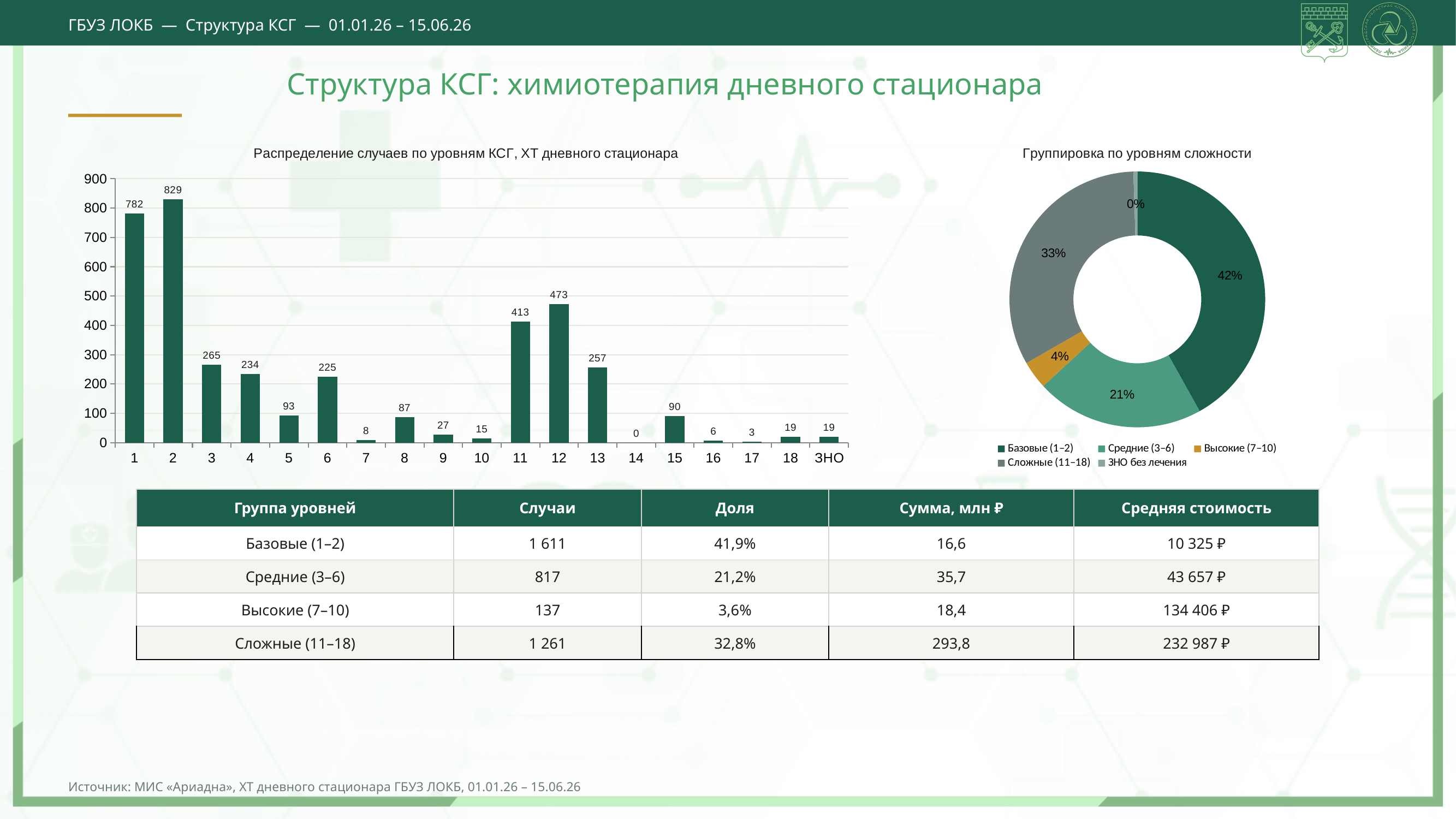
In the bar chart "Распределение случаев по уровням КСГ, ХТ дневного стационара", which is larger: the value for category 11 or category 13? 11 In the bar chart "Распределение случаев по уровням КСГ, ХТ дневного стационара", which category has the highest value? 2 In the bar chart "Распределение случаев по уровням КСГ, ХТ дневного стационара", what is the value for category 12? 473 In the donut chart "Группировка по уровням сложности", what share does the "Высокие (7–10)" slice have? 4% What kind of chart is "Распределение случаев по уровням КСГ, ХТ дневного стационара"? Bar chart In the bar chart "Распределение случаев по уровням КСГ, ХТ дневного стационара", what is the value for category 2? 829 In the bar chart "Распределение случаев по уровням КСГ, ХТ дневного стационара", which category has the lowest value? 14 In the donut chart "Группировка по уровням сложности", which group has the largest share? Базовые (1–2) In the bar chart "Распределение случаев по уровням КСГ, ХТ дневного стационара", what is the difference between the values for categories 2 and 1? 47 In the bar chart "Распределение случаев по уровням КСГ, ХТ дневного стационара", how many categories are shown on the x axis? 19 How many entries does the legend of the chart "Группировка по уровням сложности" list? 5 In the donut chart "Группировка по уровням сложности", what share does the "Сложные (11–18)" slice have? 33%